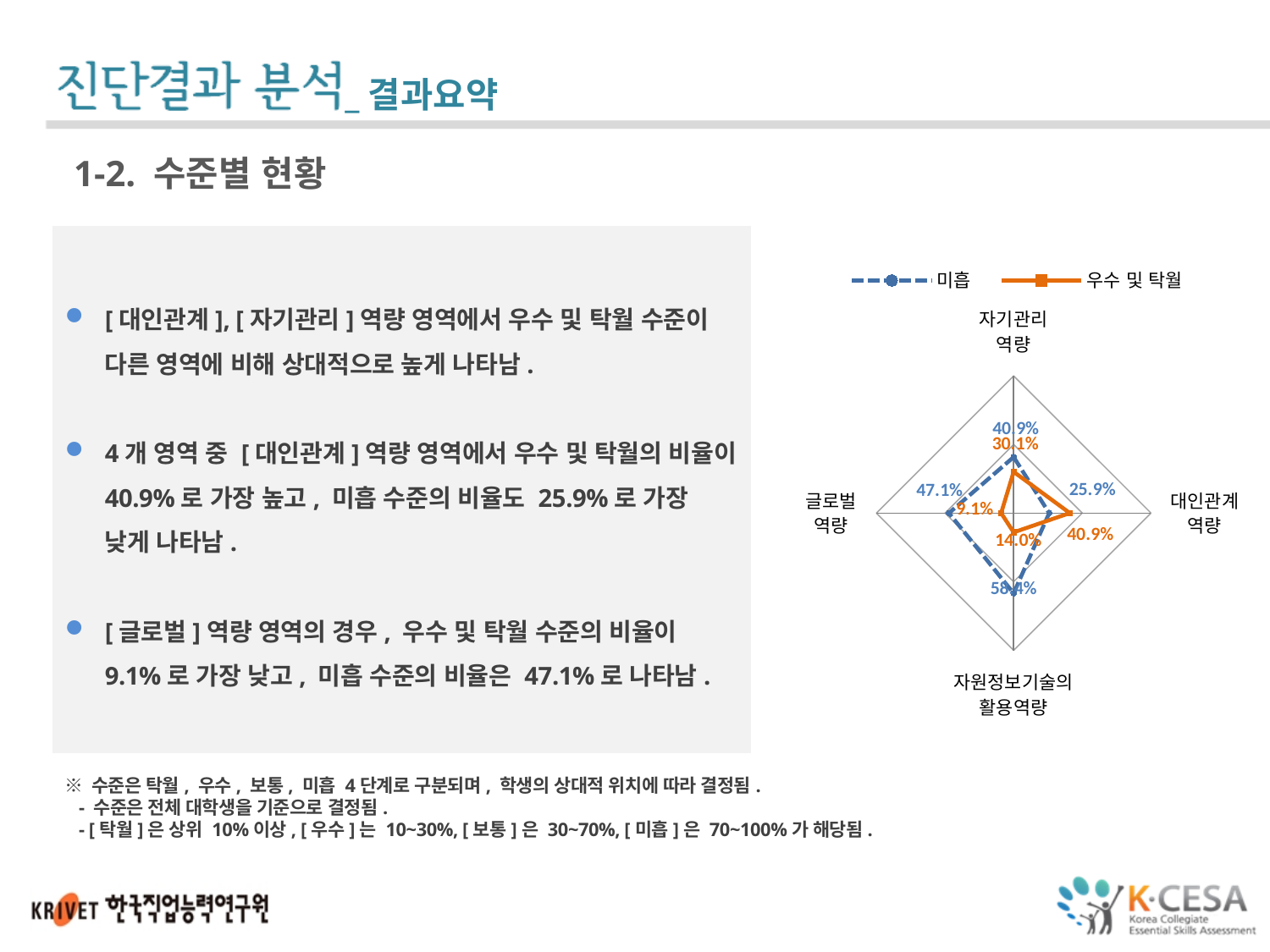
Which competency area has the highest 우수 및 탁월 value? 대인관계 역량 What is the 미흡 value for 글로벌 역량? 47.1% For 대인관계 역량, what is the difference between the 우수 및 탁월 value and the 미흡 value? 15.0% How many competency areas (axes) are plotted on the radar chart? 4 What is the 우수 및 탁월 value for 글로벌 역량? 9.1% What is the 우수 및 탁월 value for 자원정보기술의 활용역량? 14.0% What kind of chart is shown on the slide? Radar chart What is the 미흡 value for 자기관리 역량? 40.9% For 자기관리 역량, which series has the larger value, 미흡 or 우수 및 탁월? 미흡 Which competency area has the lowest 우수 및 탁월 value? 글로벌 역량 What is the 우수 및 탁월 value for 대인관계 역량? 40.9% How many series does the chart legend list? 2